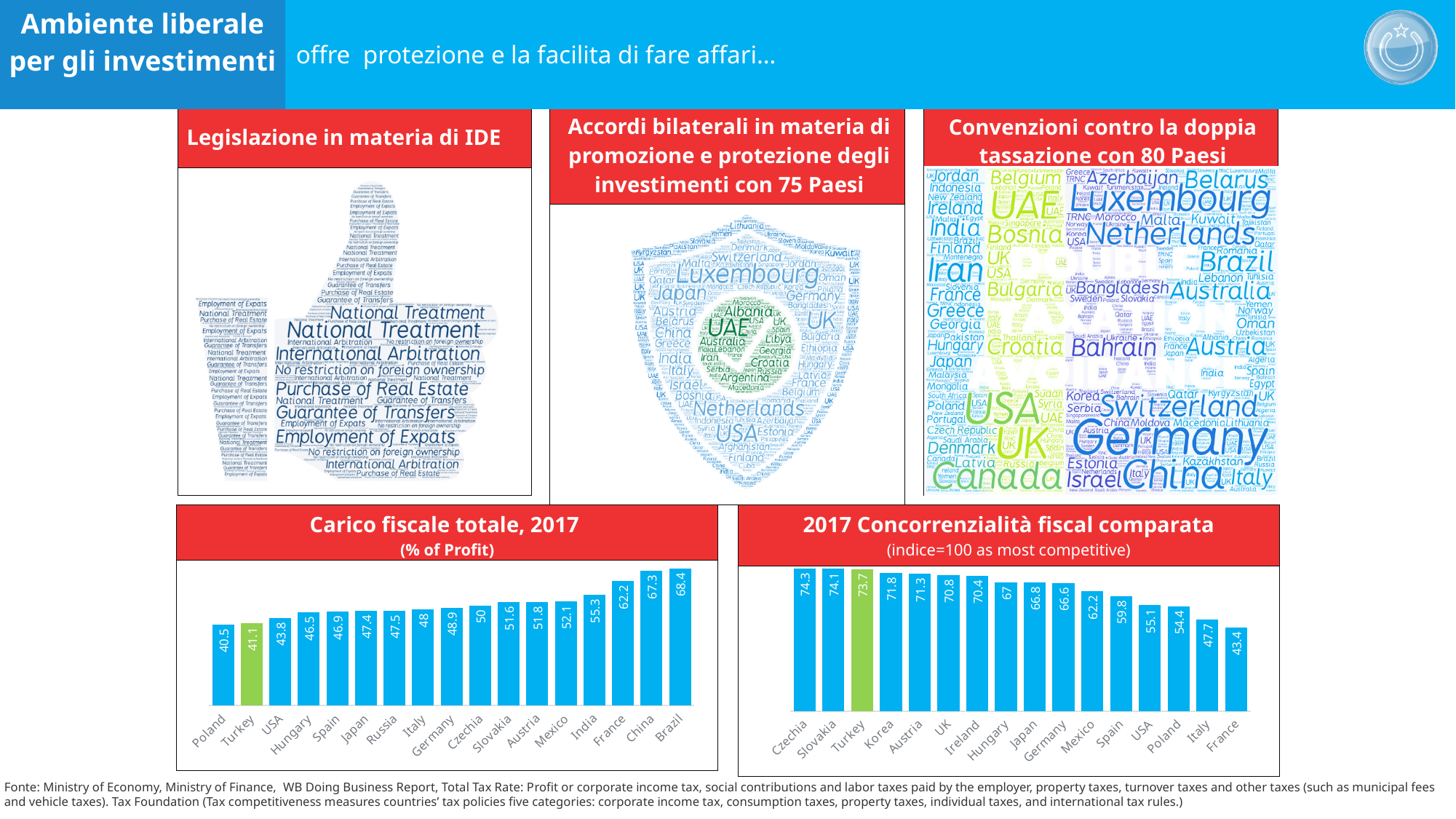
In the '2017 Concorrenzialità fiscal comparata' chart, how many countries are shown? 16 In the 'Carico fiscale totale, 2017' chart, do the values rise or fall from left to right? rise In the '2017 Concorrenzialità fiscal comparata' chart, which is larger, the value for Germany or the value for Mexico? Germany In the 'Carico fiscale totale, 2017' chart, which country has the highest value? Brazil In the 'Carico fiscale totale, 2017' chart, what is the value for Turkey? 41.1 In the 'Carico fiscale totale, 2017' chart, which country has the lowest value? Poland In the 'Carico fiscale totale, 2017' chart, how many countries are shown? 17 In the '2017 Concorrenzialità fiscal comparata' chart, which country has the highest value? Czechia In the '2017 Concorrenzialità fiscal comparata' chart, which country has the lowest value? France In the '2017 Concorrenzialità fiscal comparata' chart, what is the value for Turkey? 73.7 In the 'Carico fiscale totale, 2017' chart, what is the difference between the values for China and France? 5.1 What type of chart is the 'Carico fiscale totale, 2017' chart? bar chart